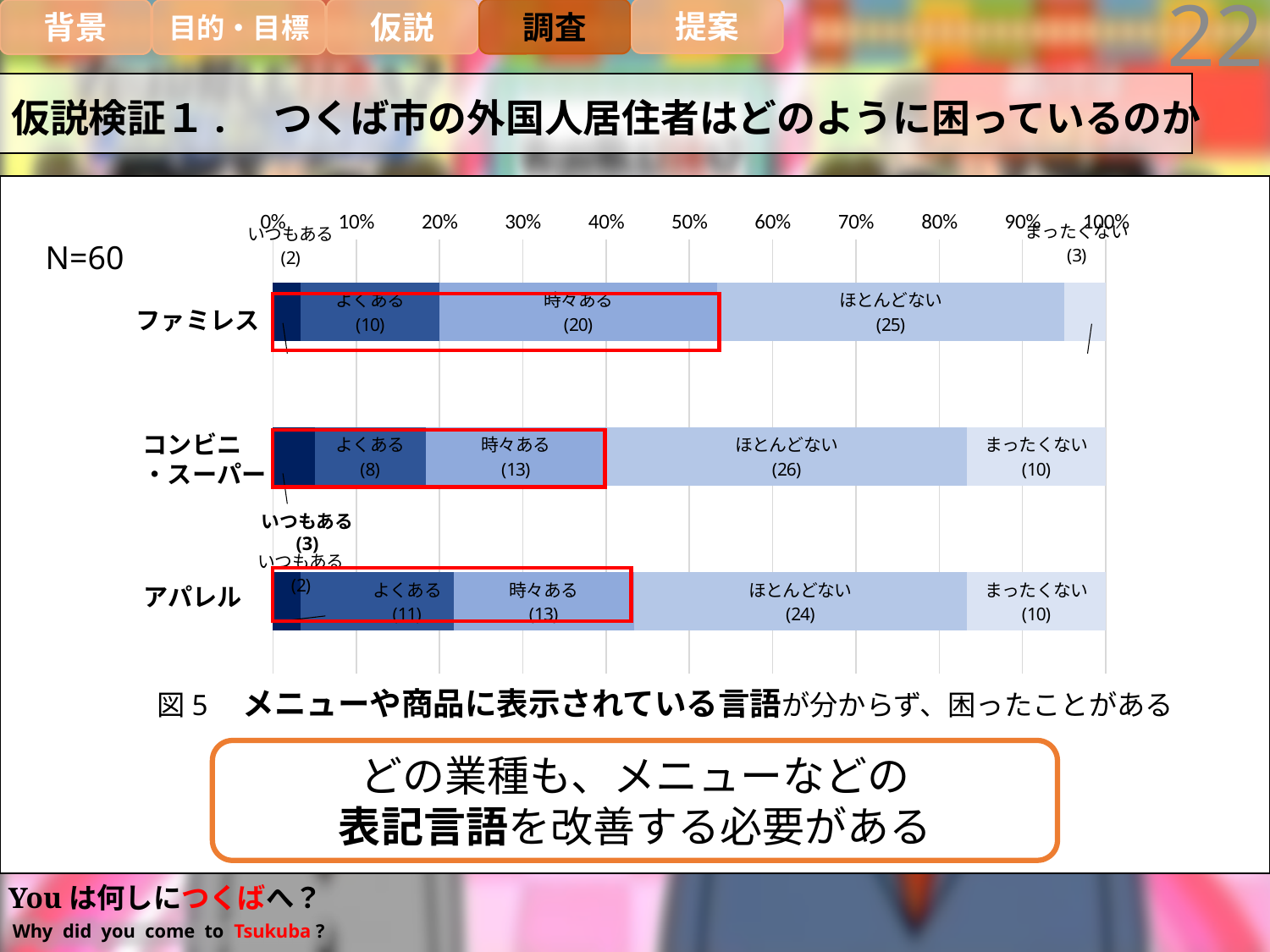
How many categories (business types) are plotted on the chart? 3 What is the value labelled for 時々ある in the ファミレス bar? (20) What is the total of all segments in the ファミレス bar? 60 What is the value labelled for よくある in the アパレル bar? (11) Which is larger: the よくある value for ファミレス or for コンビニ・スーパー? ファミレス What kind of chart is shown on the slide? Stacked bar chart Which category has the lowest value for 時々ある? コンビニ・スーパー and アパレル (both 13) Which category has the highest value for まったくない? コンビニ・スーパー and アパレル (both 10) What is the difference between the ほとんどない values for コンビニ・スーパー and アパレル? 2 What is the sample size (N) shown next to the chart? N=60 What is the value labelled for ほとんどない in the コンビニ・スーパー bar? (26) What is the value labelled for まったくない in the ファミレス bar? (3)